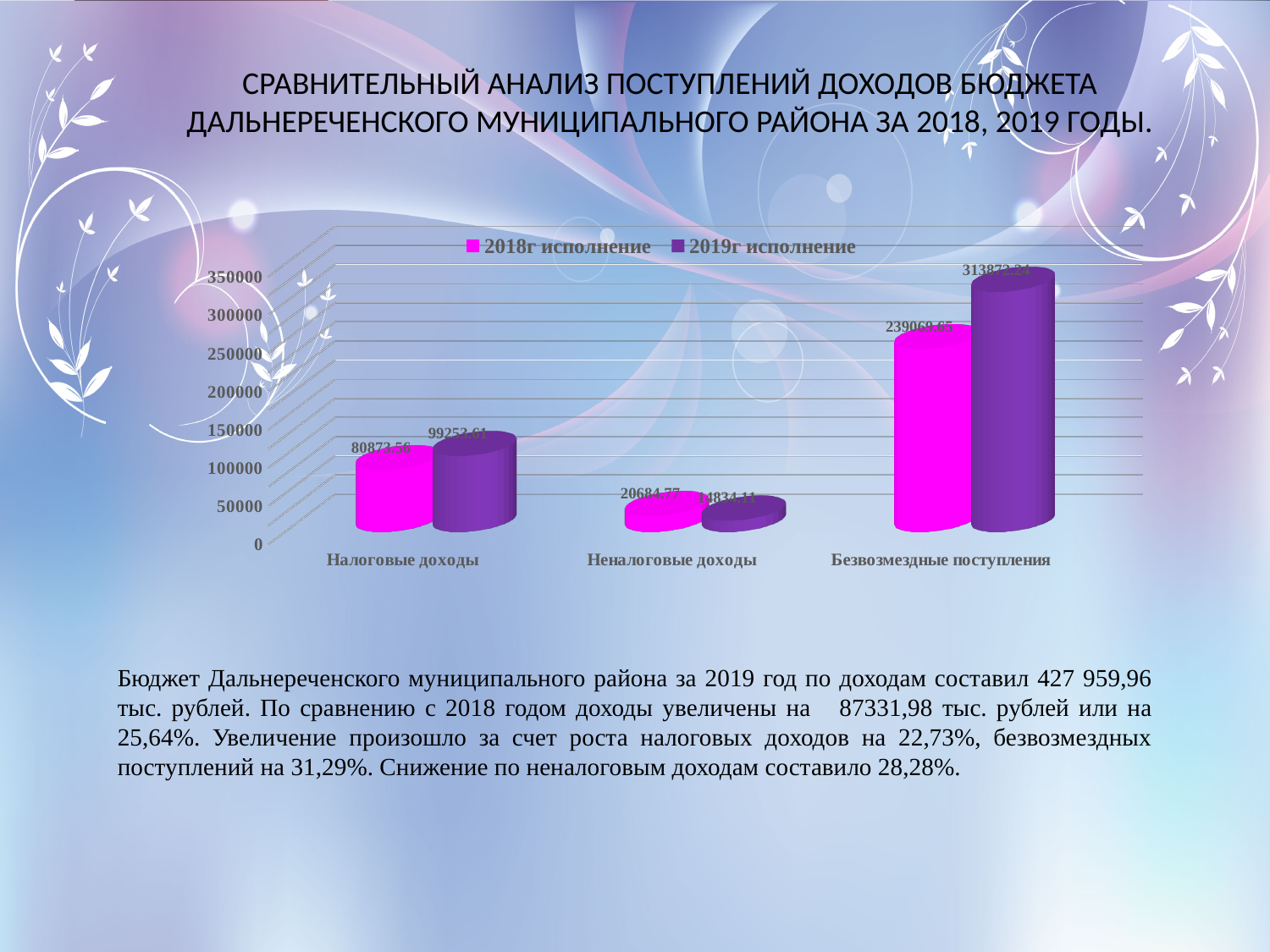
What type of chart is shown on the slide? bar chart What is the difference between the 2019г исполнение and 2018г исполнение values for Налоговые доходы? 18380.05 For Неналоговые доходы, which is larger: 2018г исполнение or 2019г исполнение? 2018г исполнение How many categories are shown on the x axis? 3 What is the value of 2018г исполнение for Неналоговые доходы? 20684.77 Which category has the highest value for 2019г исполнение? Безвозмездные поступления Which series is shown in magenta in the legend? 2018г исполнение How many series does the legend list? 2 Is the value of 2019г исполнение for Безвозмездные поступления greater or less than 300000? greater What is the value of 2019г исполнение for Налоговые доходы? 99253.61 Which category has the lowest value for 2018г исполнение? Неналоговые доходы What is the value of 2018г исполнение for Налоговые доходы? 80873.56